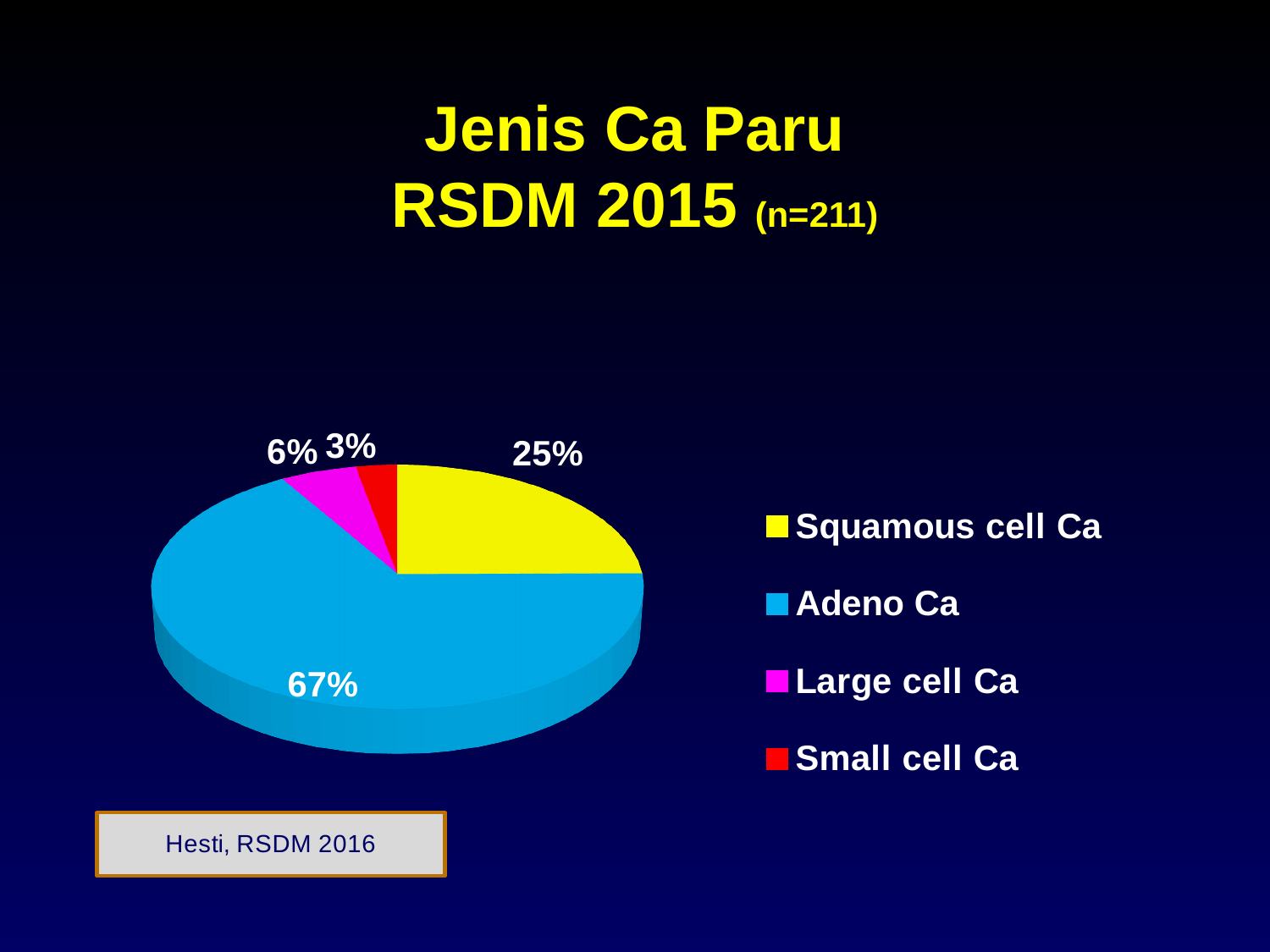
How many categories are shown in the pie chart? 4 What kind of chart is shown on the slide? Pie chart Which category has the smallest slice of the pie? Small cell Ca What share of the pie does Squamous cell Ca represent? 25% What share of the pie does Adeno Ca represent? 67% Which category has the largest slice of the pie? Adeno Ca What colour is the slice for Squamous cell Ca? Yellow What is the difference in percentage points between Adeno Ca and Squamous cell Ca? 42 Which is larger, the share for Large cell Ca or the share for Small cell Ca? Large cell Ca What is the sample size (n) stated in the slide title? 211 What share of the pie does Large cell Ca represent? 6%